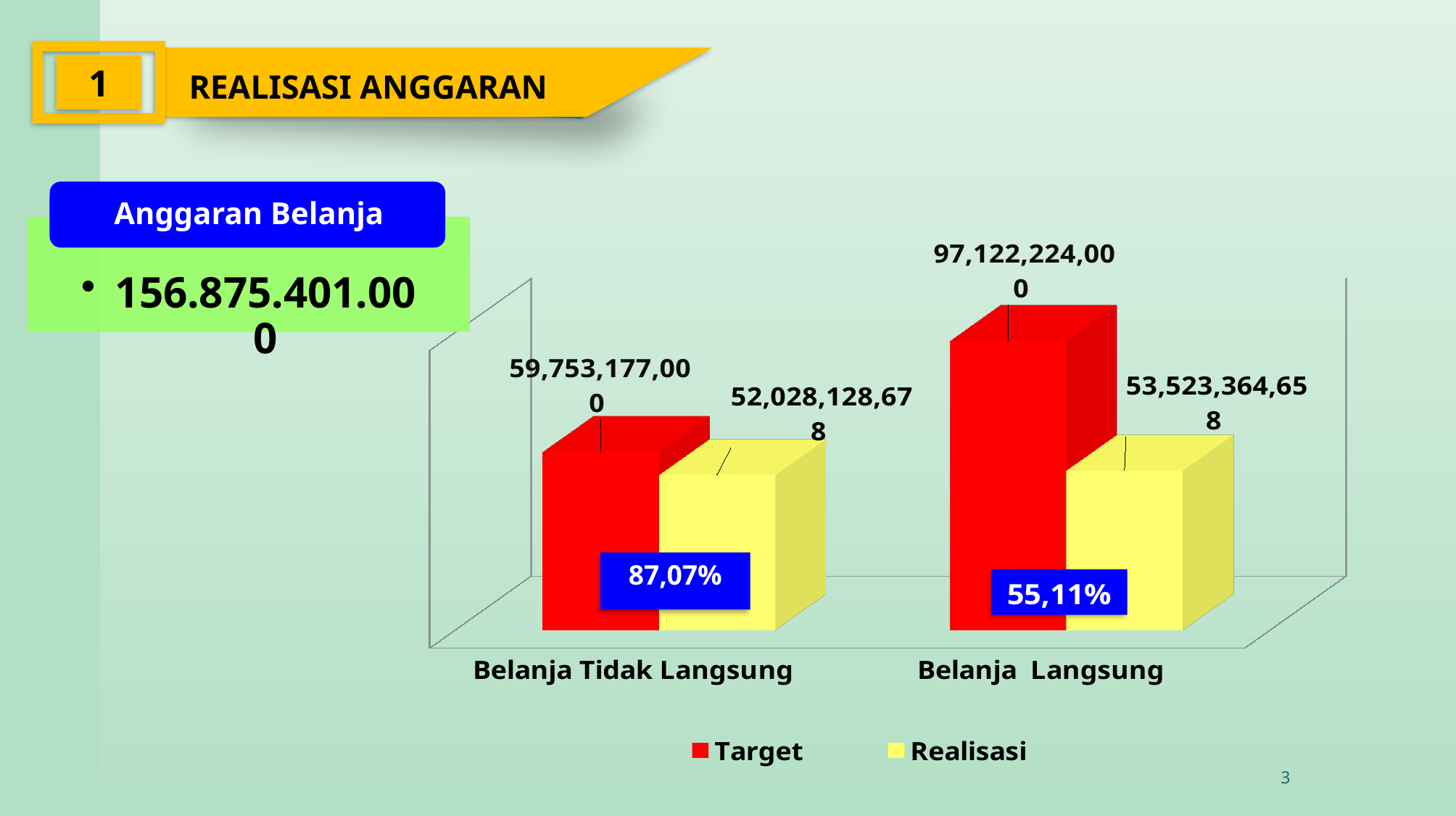
What is the Realisasi value for Belanja Tidak Langsung? 52,028,128,678 Which is larger, the Target for Belanja Langsung or the Target for Belanja Tidak Langsung? Target for Belanja Langsung What is the difference between the Target and Realisasi values for Belanja Tidak Langsung? 7,725,048,322 How many series does the chart legend list? 2 What is the Target value for Belanja Langsung? 97,122,224,000 Which bar in the chart has the lowest value? Realisasi for Belanja Tidak Langsung How many categories are shown on the x axis of the chart? 2 What is the Target value for Belanja Tidak Langsung? 59,753,177,000 Which category has the highest Target value? Belanja Langsung What is the difference between the Target and Realisasi values for Belanja Langsung? 43,598,859,342 What type of chart is shown on the slide? Bar chart What is the Realisasi value for Belanja Langsung? 53,523,364,658